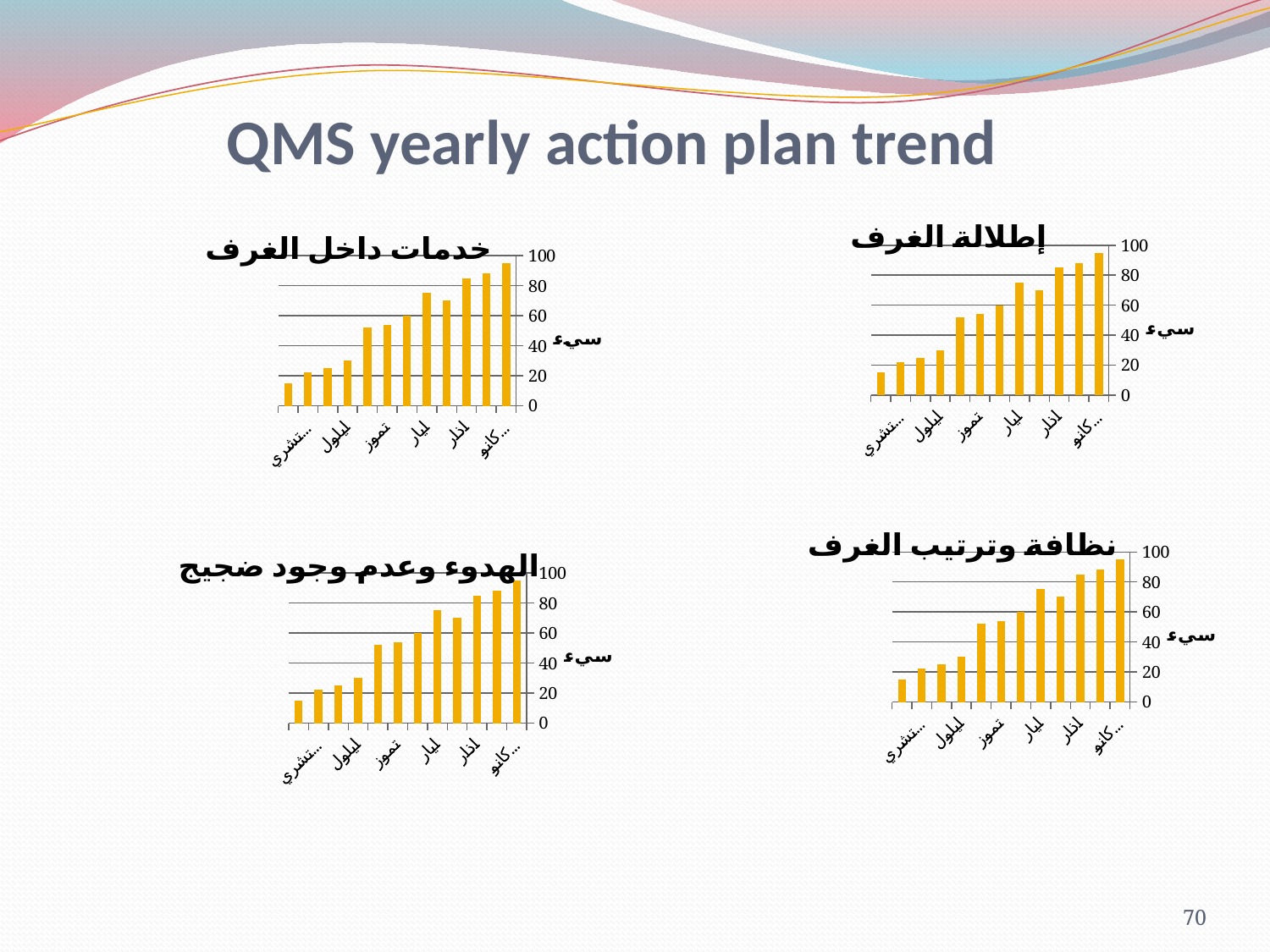
How many bars are plotted in the bottom-left chart titled "الهدوء وعدم وجود ضجيج"? 12 In the bottom-right chart titled "نظافة وترتيب الغرف", do the values generally rise or fall from left to right along the x axis? rise How many charts are shown on the slide? 4 In the bottom-right chart titled "نظافة وترتيب الغرف", is the value of the rightmost bar greater or less than 80? greater In the bottom-left chart titled "الهدوء وعدم وجود ضجيج", is the value of the leftmost bar greater or less than 20? less What is the title of the slide? QMS yearly action plan trend In the top-right chart titled "إطلالة الغرف", is the value of the rightmost bar greater or less than 80? greater What kind of chart is the top-left chart titled "خدمات داخل الغرف"? bar chart In the top-right chart titled "إطلالة الغرف", which bar is larger, the leftmost bar or the rightmost bar? the rightmost bar In the bottom-left chart titled "الهدوء وعدم وجود ضجيج", do the values generally rise or fall from left to right along the x axis? rise How many bars are plotted in the top-right chart titled "إطلالة الغرف"? 12